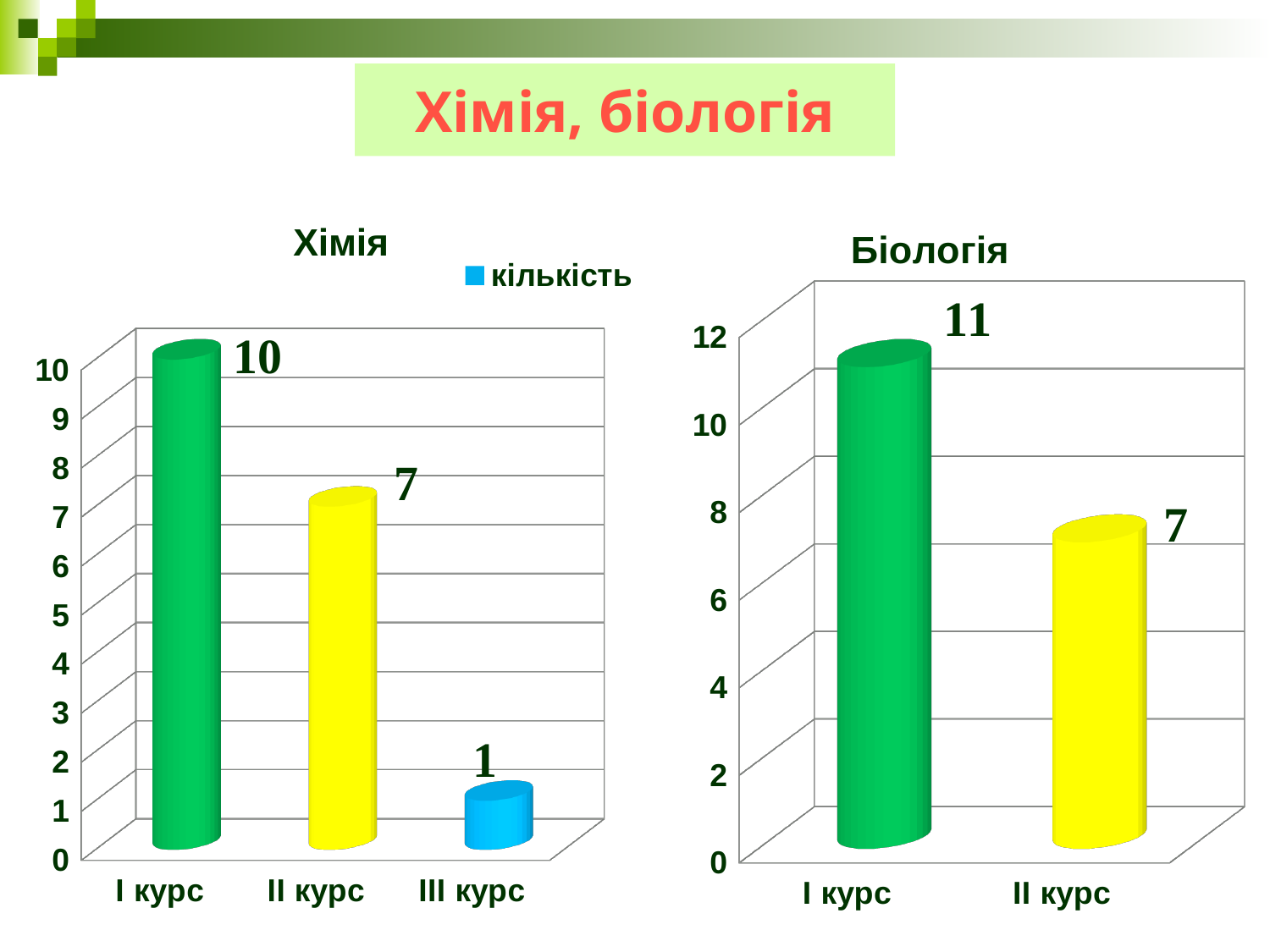
In the Хімія chart, what is the difference between the values for I курс and II курс? 3 In the Біологія chart, what is the difference between the values for I курс and II курс? 4 In the Хімія chart, which category has the lowest value? III курс In the Хімія chart, what is the value for III курс? 1 In the Хімія chart, which category has the highest value? I курс In the Хімія chart, what is the value for I курс? 10 What kind of chart is the Біологія chart? bar chart In the Хімія chart, which is larger: the value for II курс or III курс? II курс What is the legend entry shown in the Хімія chart? кількість In the Біологія chart, what is the value for I курс? 11 In the Біологія chart, what is the value for II курс? 7 How many categories are shown in the Хімія chart? 3